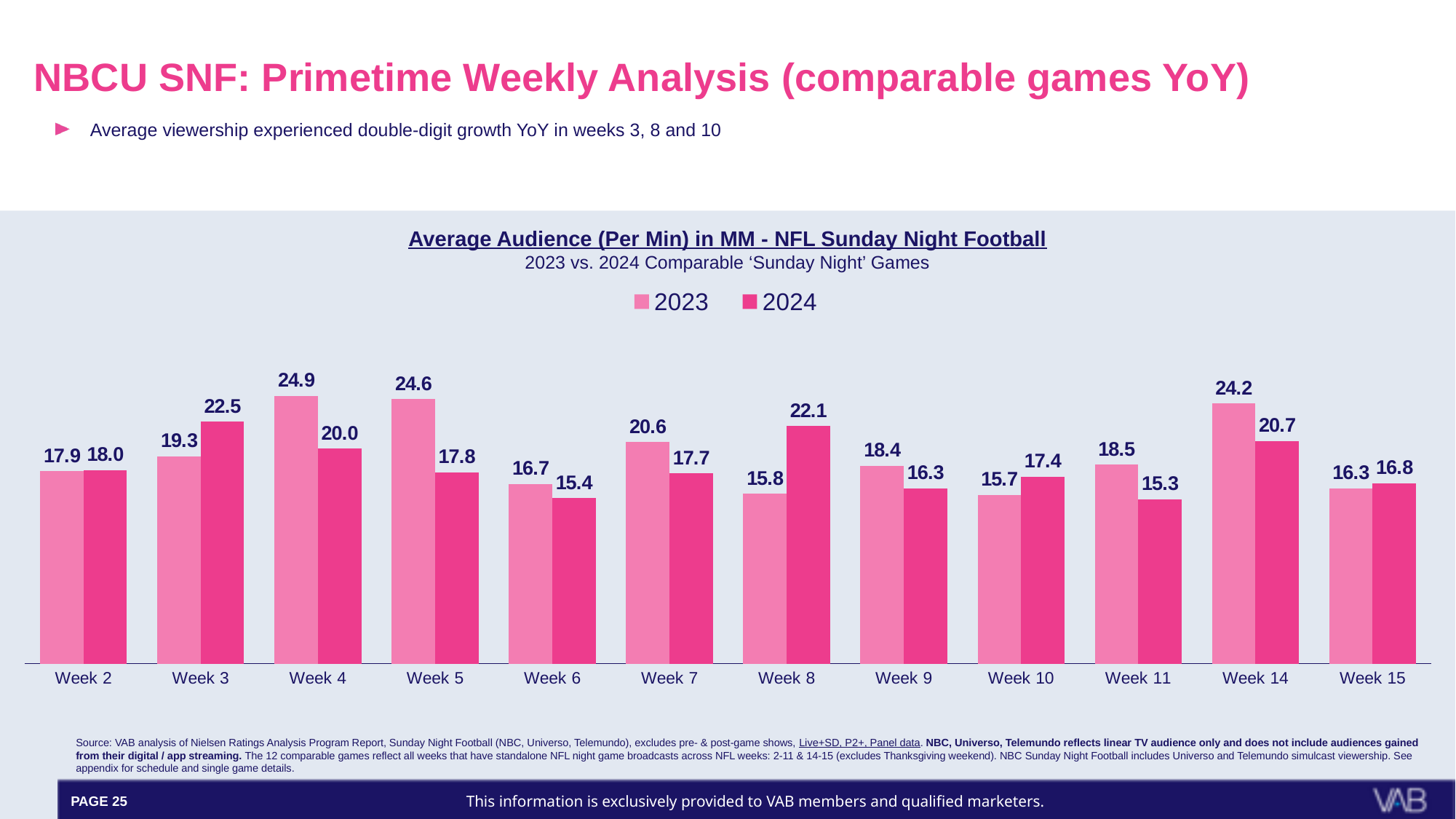
How many weeks are shown on the x axis of the chart? 12 What is the difference between the 2024 and 2023 average audience for Week 8? 6.3 Which week had the lowest 2023 average audience? Week 10 What was the 2023 average audience for Week 4? 24.9 For Week 14, which year had the larger average audience, 2023 or 2024? 2023 Which week had the highest 2024 average audience? Week 3 What type of chart is used to show the average audience data? Bar chart Which week had the lowest 2024 average audience? Week 11 What was the 2024 average audience for Week 8? 22.1 What is the difference between the 2023 and 2024 average audience for Week 5? 6.8 Which week had the highest 2023 average audience? Week 4 What was the 2024 average audience for Week 11? 15.3